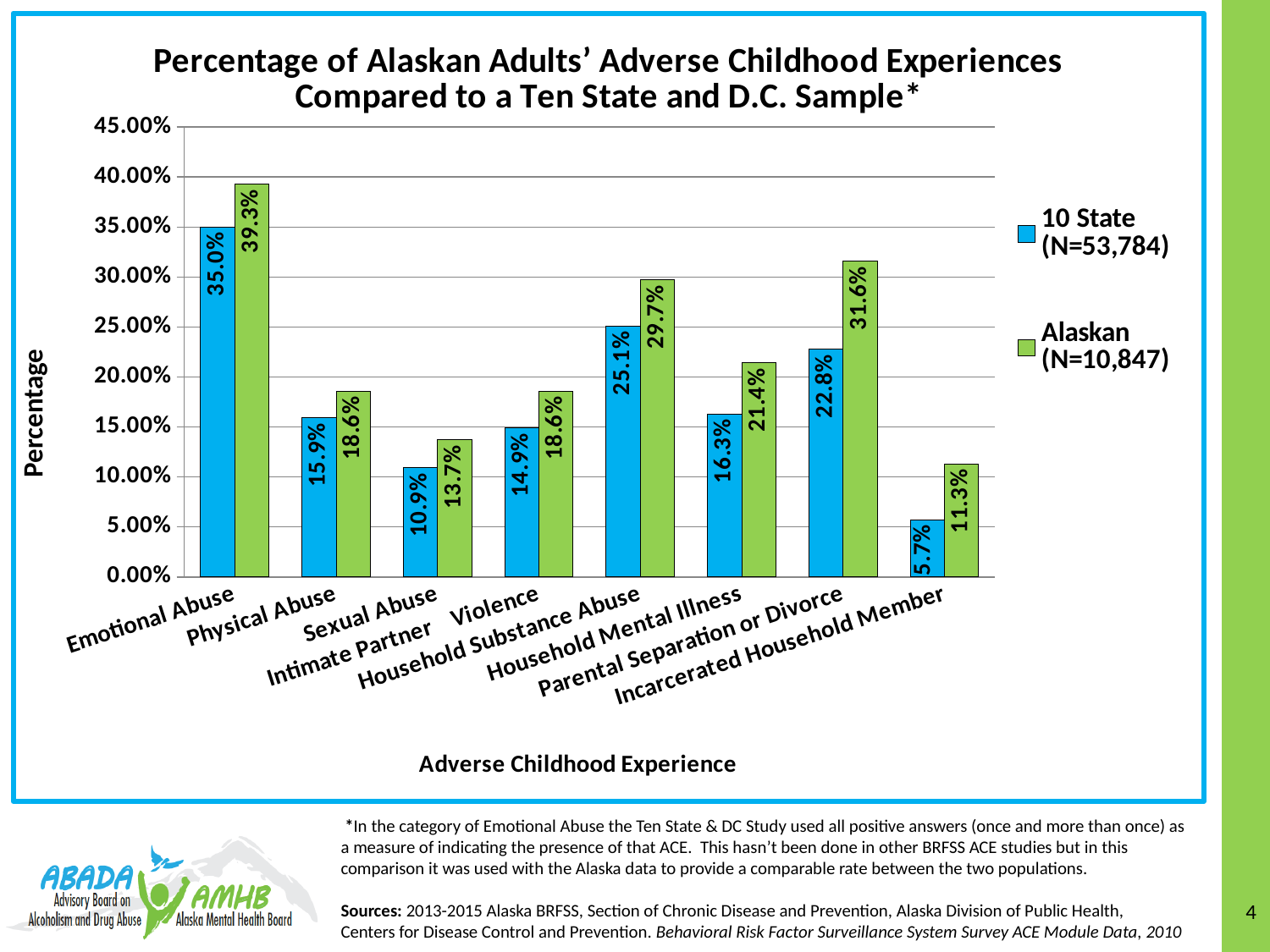
Which adverse childhood experience has the highest 10 State value? Emotional Abuse What is the Alaskan value for Emotional Abuse? 39.3% Which adverse childhood experience has the lowest Alaskan value? Incarcerated Household Member Which is larger for Sexual Abuse: the 10 State value or the Alaskan value? Alaskan What kind of chart is shown on the slide? Bar chart What is the difference between the Alaskan and 10 State values for Household Mental Illness? 5.1% What is the difference between the Alaskan and 10 State values for Parental Separation or Divorce? 8.8% What is the 10 State value for Parental Separation or Divorce? 22.8% How many adverse childhood experience categories are shown on the x axis? 8 How many series does the legend list? 2 What is the Alaskan value for Incarcerated Household Member? 11.3% Is the 10 State value for Household Substance Abuse greater or less than 20.00%? greater